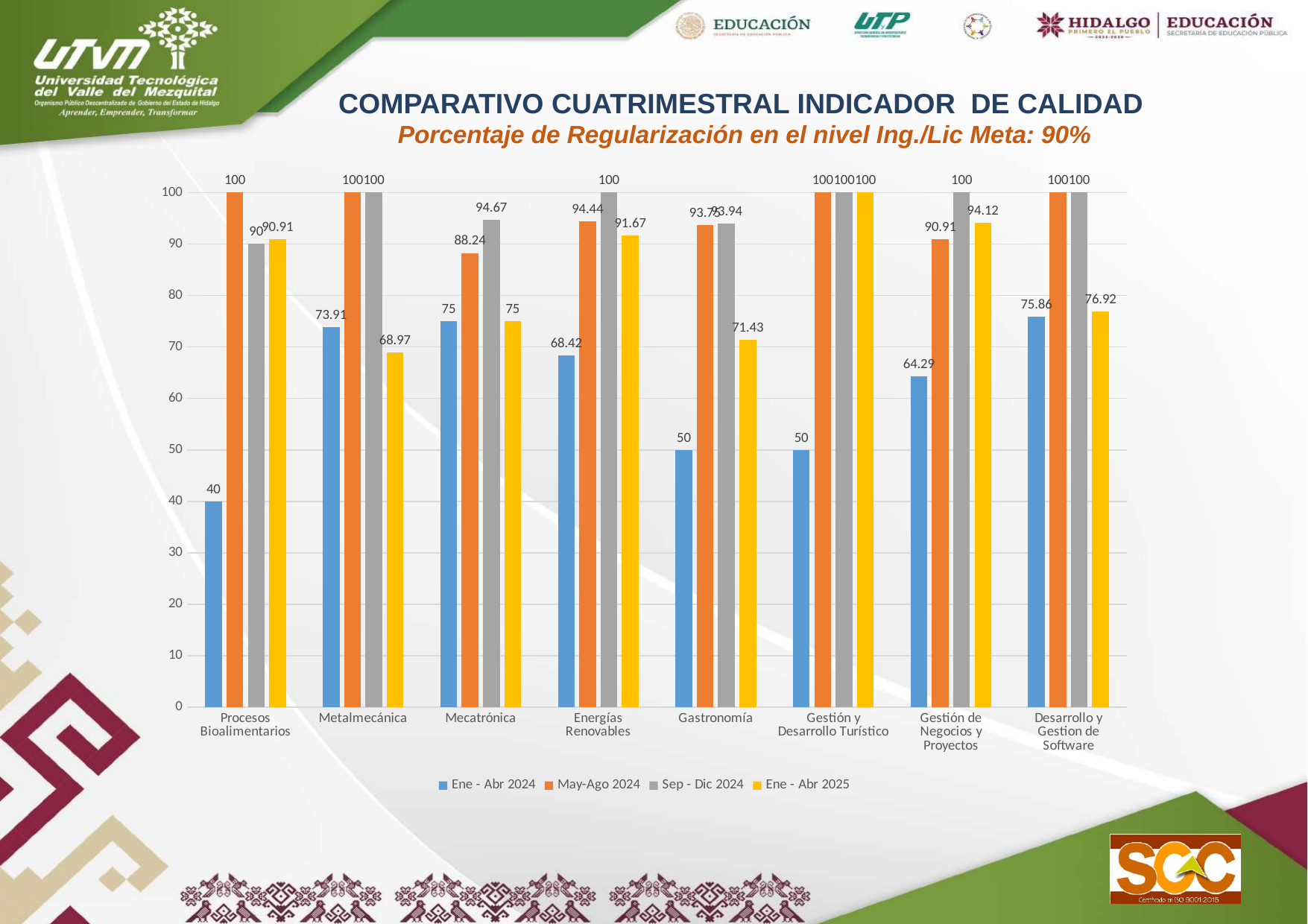
Which category has the highest value in the Ene - Abr 2025 series? Gestión y Desarrollo Turístico What is the value for Mecatrónica in the Sep - Dic 2024 series? 94.67 Is the Ene - Abr 2025 value for Gastronomía greater or less than 80? less What kind of chart is shown on the slide? Bar chart What is the value for Metalmecánica in the Ene - Abr 2025 series? 68.97 How many series does the legend list? 4 How many categories are shown on the x axis? 8 What is the difference between the Sep - Dic 2024 and Ene - Abr 2024 values for Energías Renovables? 31.58 What is the value for Gestión de Negocios y Proyectos in the May-Ago 2024 series? 90.91 Which is larger for Desarrollo y Gestion de Software: the Ene - Abr 2024 value or the Ene - Abr 2025 value? Ene - Abr 2025 What is the value for Procesos Bioalimentarios in the Ene - Abr 2024 series? 40 Which category has the lowest value in the Ene - Abr 2024 series? Procesos Bioalimentarios